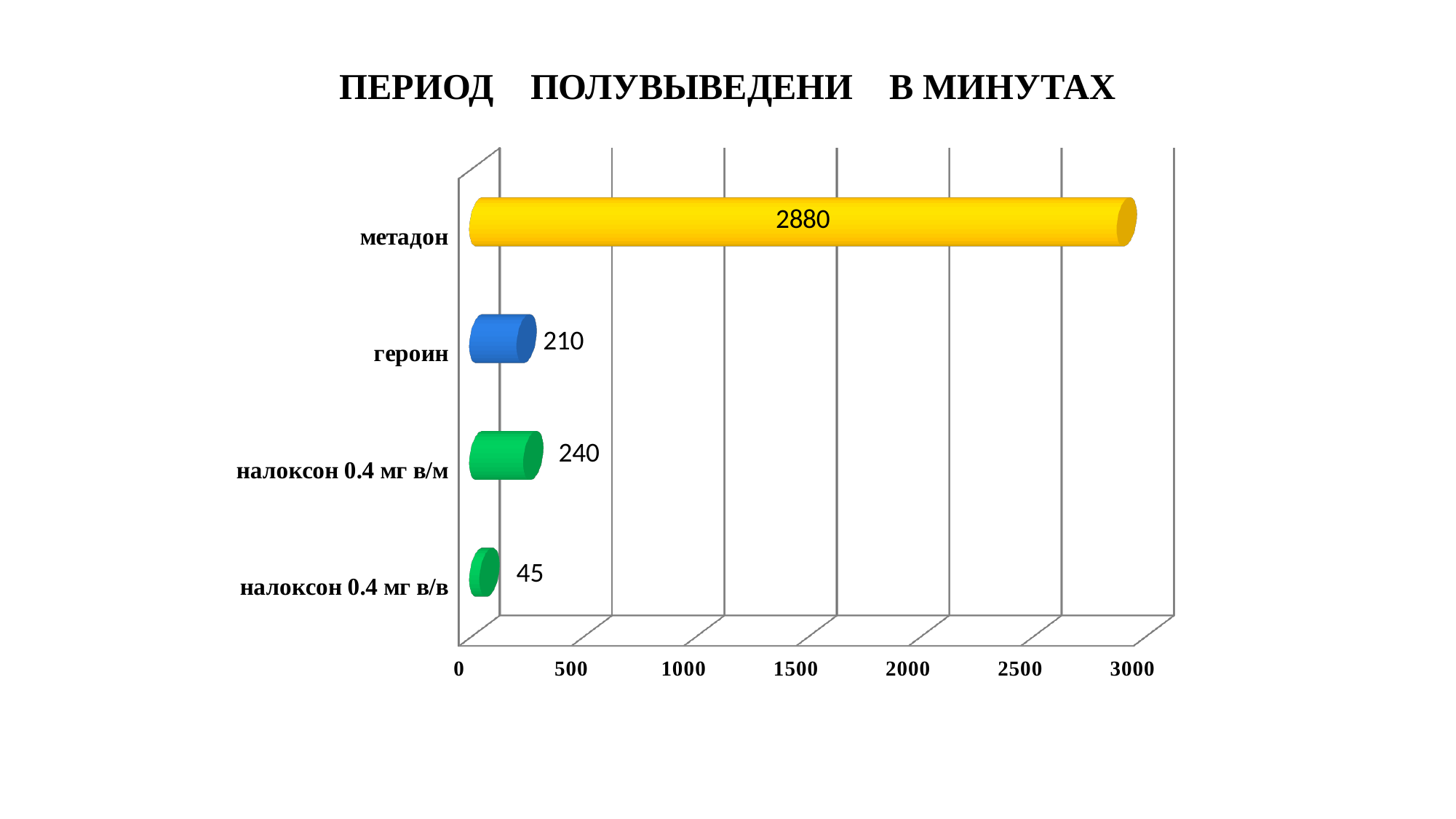
What is the value for налоксон 0.4 мг в/м? 240 Which category has the highest value? метадон What is the difference between the values for налоксон 0.4 мг в/м and налоксон 0.4 мг в/в? 195 Which category has the lowest value? налоксон 0.4 мг в/в Which is larger, the value for героин or the value for налоксон 0.4 мг в/м? налоксон 0.4 мг в/м What is the title of the chart? ПЕРИОД ПОЛУВЫВЕДЕНИ В МИНУТАХ What kind of chart is shown on the slide? bar chart What is the difference between the values for метадон and героин? 2670 What is the value for метадон? 2880 What is the value for героин? 210 What is the value for налоксон 0.4 мг в/в? 45 How many categories are shown in the chart? 4